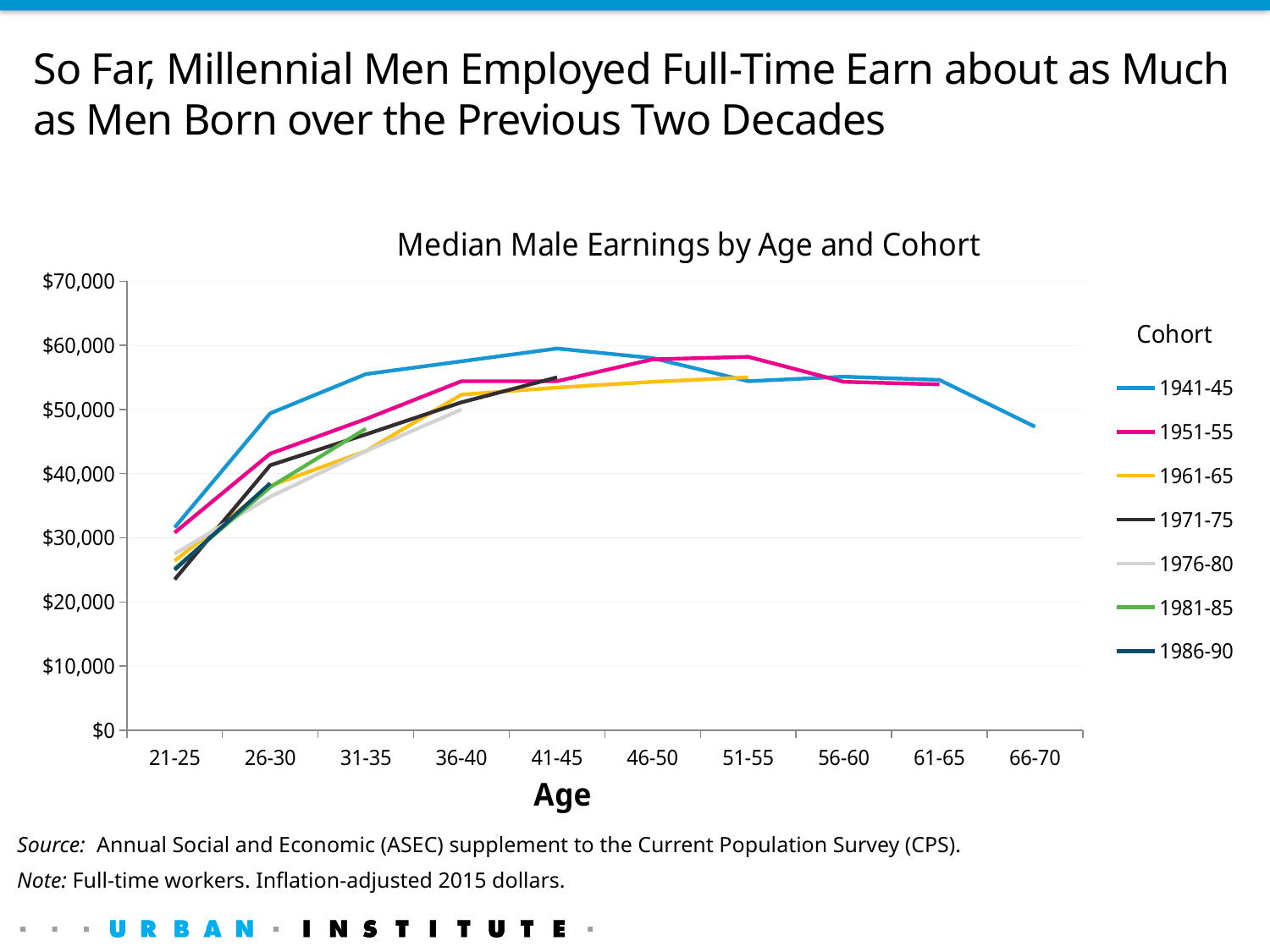
At age 21-25, which cohort has the higher value, 1941-45 or 1971-75? 1941-45 At age 51-55, which cohort has the higher value, 1951-55 or 1941-45? 1951-55 What kind of chart is shown on the slide? line chart What is the title of the chart? Median Male Earnings by Age and Cohort Is the value for the 1986-90 cohort at age 21-25 greater or less than $30,000? less What is the title of the legend? Cohort How many cohorts does the legend list? 7 Is the value for the 1981-85 cohort at age 31-35 greater or less than $40,000? greater Does the 1941-45 cohort line rise or fall from age 21-25 to age 41-45? rise Is the value for the 1941-45 cohort at age 41-45 greater or less than $50,000? greater How many age groups are shown on the x axis? 10